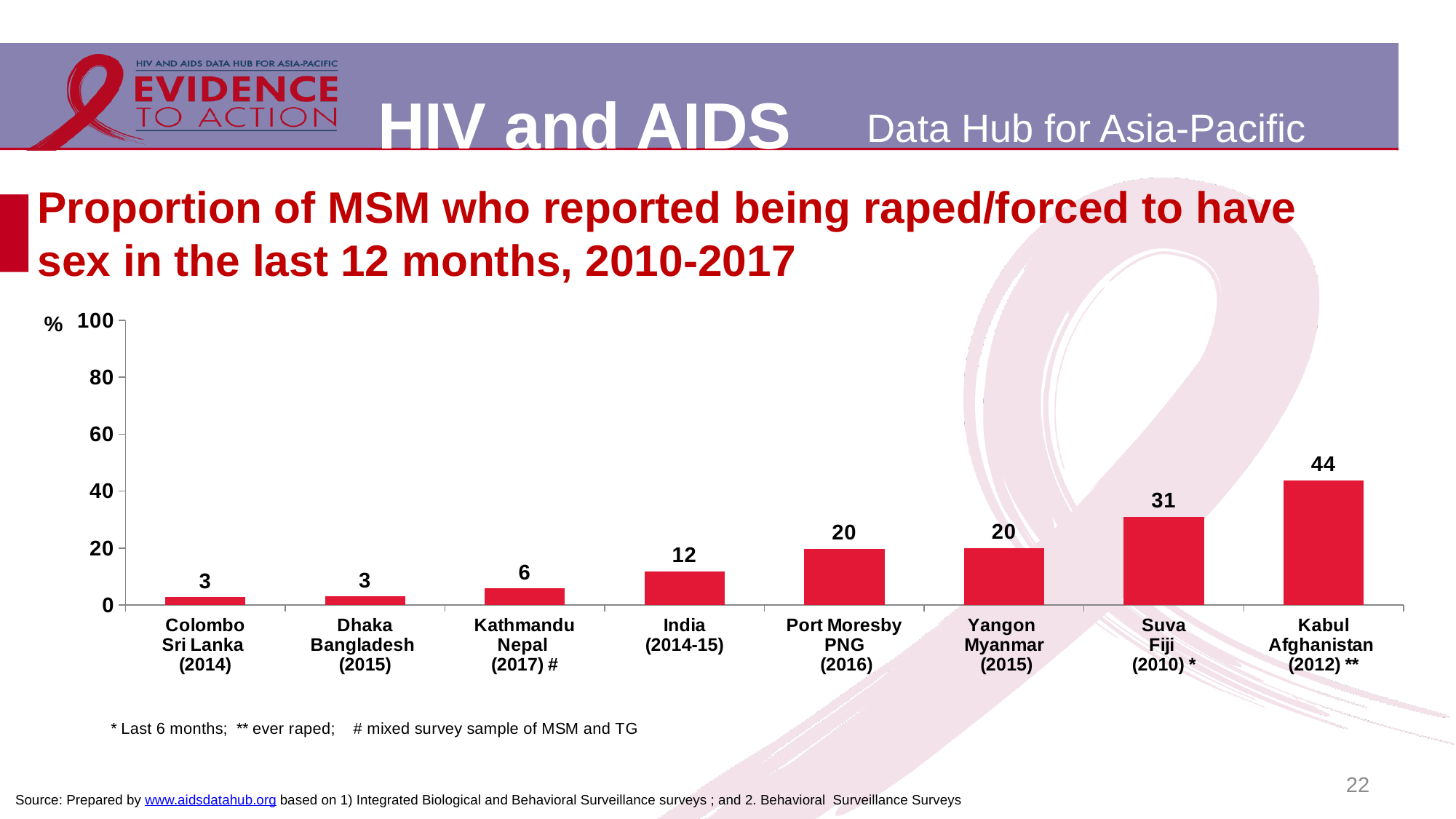
What kind of chart is shown on the slide? Bar chart What is the value for India (2014-15)? 12 What is the value for Suva, Fiji (2010)? 31 Which is larger, the value for Port Moresby, PNG or the value for India? Port Moresby, PNG Do the values generally rise or fall from left to right across the chart? Rise Which location has the highest proportion of MSM who reported being raped/forced to have sex? Kabul, Afghanistan (2012) What is the value for Kabul, Afghanistan (2012)? 44 What is the difference between the values for Kabul, Afghanistan and Suva, Fiji? 13 What unit is shown on the y axis of the chart? % What is the lowest value shown on the chart? 3 How many locations are shown on the chart? 8 Is the value for Kabul, Afghanistan greater or less than 40? greater